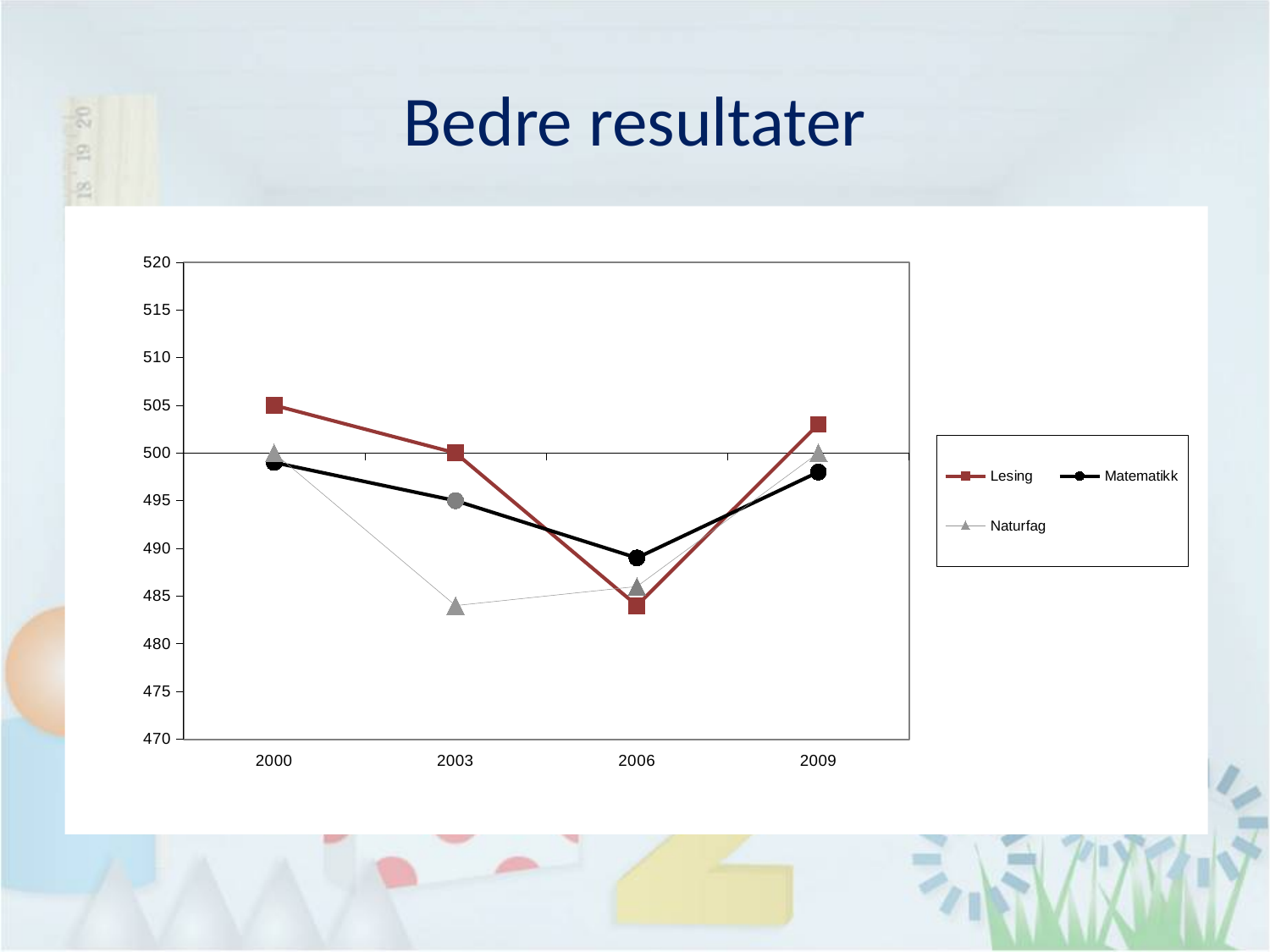
What is the value for Lesing in 2003? 500 What is the value for Matematikk in 2003? 495 How many series does the legend list? 3 In which year is the Lesing series at its highest? 2000 What is the title of the slide? Bedre resultater Is the value for Naturfag in 2003 greater or less than 490? less How many years are plotted along the x axis? 4 In 2006, which series has the higher value, Lesing or Matematikk? Matematikk What is the value for Lesing in 2000? 505 In which year is the Lesing series at its lowest? 2006 Is the value for Lesing in 2006 greater or less than 490? less What kind of chart is shown on the slide? line chart